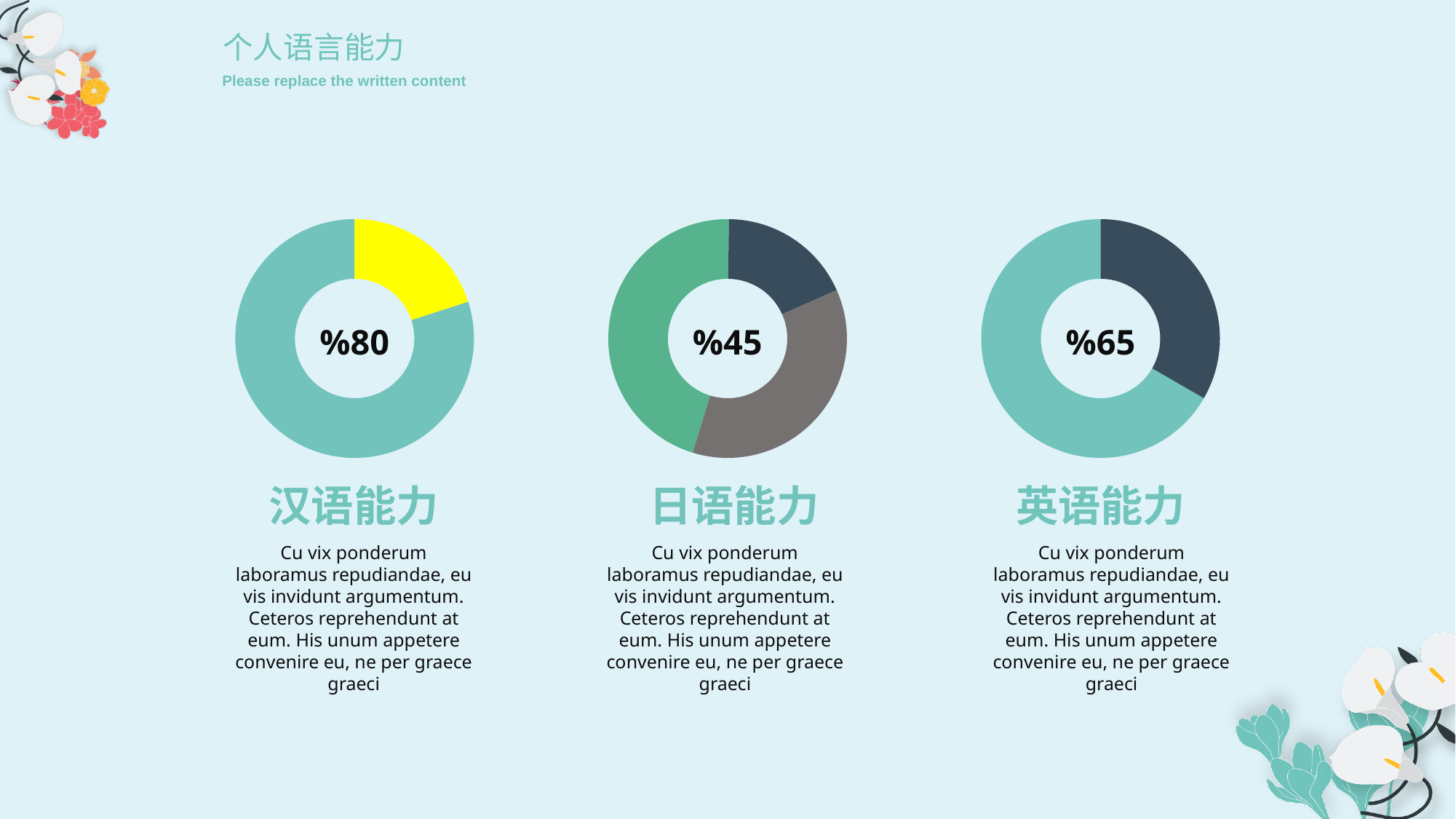
How many donut charts are on the slide? 3 Which language ability chart contains a yellow slice? 汉语能力 What kind of chart is used to show each language ability on this slide? Donut chart What value is shown in the centre of the 汉语能力 donut chart? %80 Which of the three language abilities has the highest value shown? 汉语能力 What is the title of the slide? 个人语言能力 Which of the three language abilities has the lowest value shown? 日语能力 Which is larger, the value for 英语能力 or the value for 日语能力? 英语能力 What is the difference between the value for 英语能力 and the value for 日语能力? 20 What value is shown in the centre of the 日语能力 donut chart? %45 What value is shown in the centre of the 英语能力 donut chart? %65 What is the difference between the value for 汉语能力 and the value for 英语能力? 15